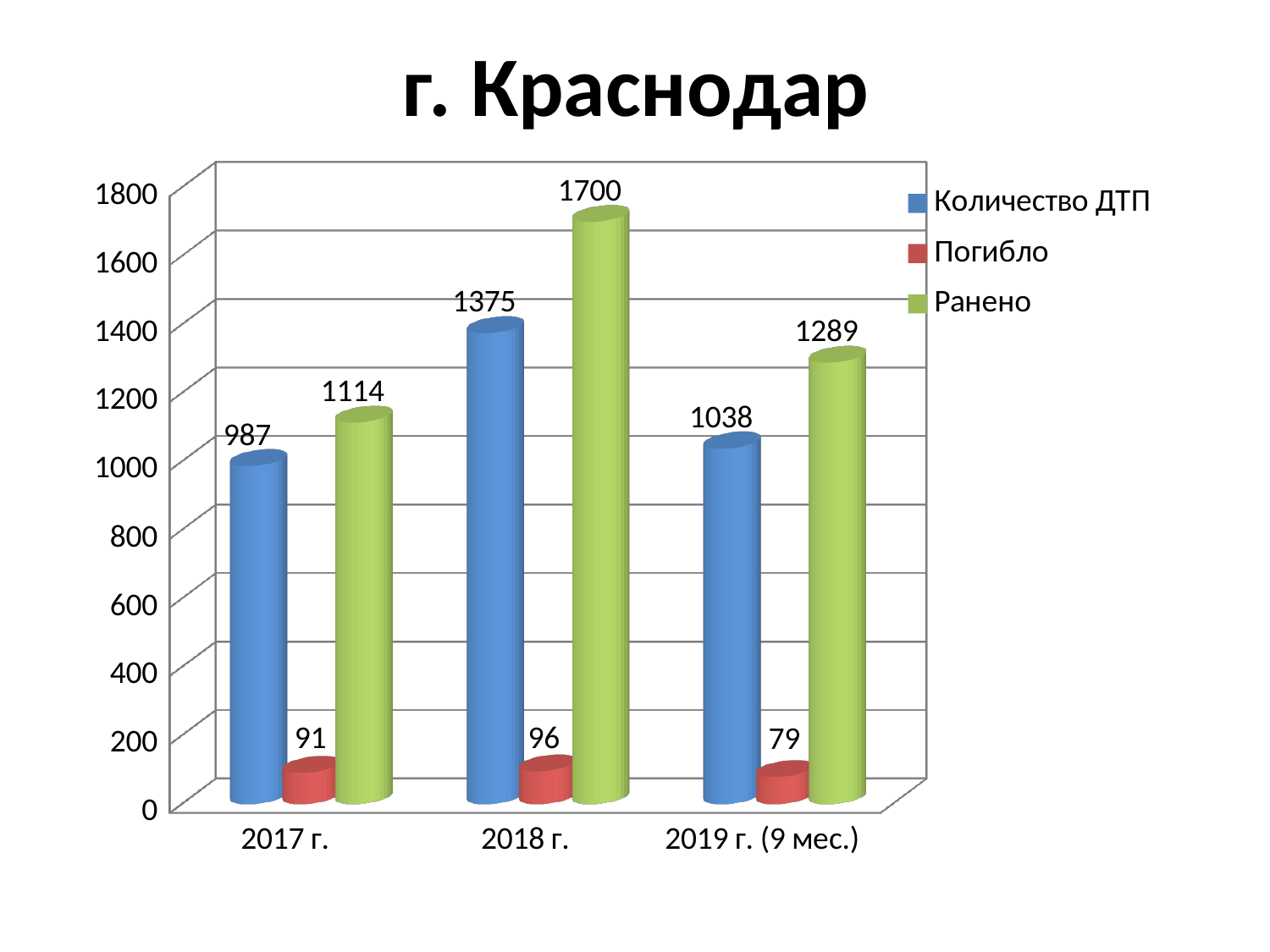
What is the value of Количество ДТП for 2018 г.? 1375 Which colour represents the Погибло series? Red What is the difference between Количество ДТП in 2018 г. and 2017 г.? 388 How many year categories are shown on the x axis? 3 What is the value of Погибло for 2019 г. (9 мес.)? 79 What kind of chart is shown on the slide? Bar chart Which year has the lowest value for Погибло? 2019 г. (9 мес.) Which is larger: Ранено in 2019 г. (9 мес.) or Ранено in 2017 г.? Ранено in 2019 г. (9 мес.) What is the value of Ранено for 2017 г.? 1114 How many series does the legend list? 3 Which year has the highest value for Ранено? 2018 г. What is the title of the slide? г. Краснодар